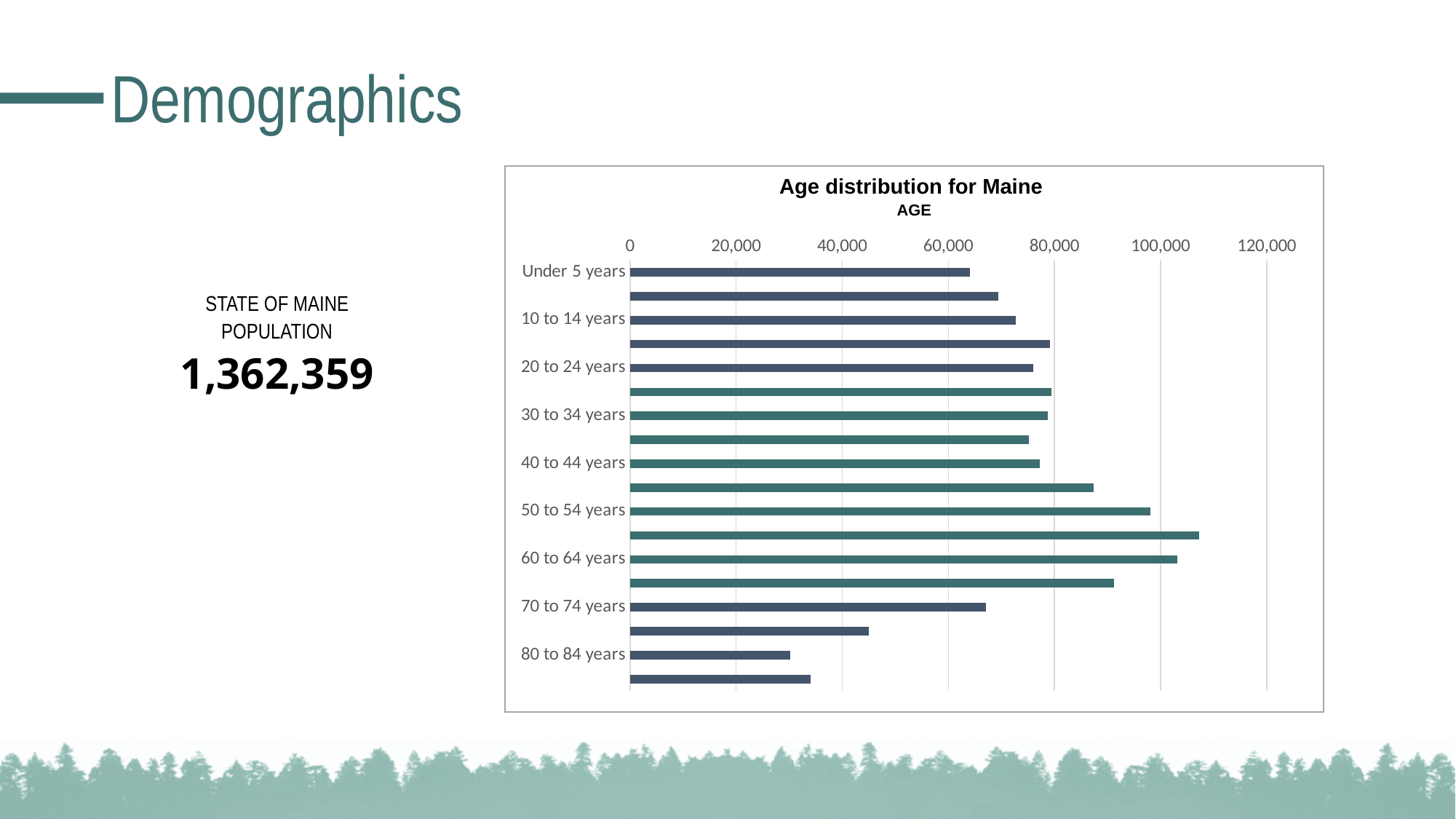
Is the value for 80 to 84 years greater or less than 40,000? less Is the value for 70 to 74 years greater or less than 60,000? greater Is the value for 50 to 54 years greater or less than 80,000? greater What is the title of the chart? Age distribution for Maine Which is larger, the value for 70 to 74 years or the value for 80 to 84 years? 70 to 74 years Which of the labeled age groups has the lowest value? 80 to 84 years What kind of chart is shown on the slide? bar chart Which of the labeled age groups has the highest value? 60 to 64 years Which is larger, the value for 50 to 54 years or the value for Under 5 years? 50 to 54 years